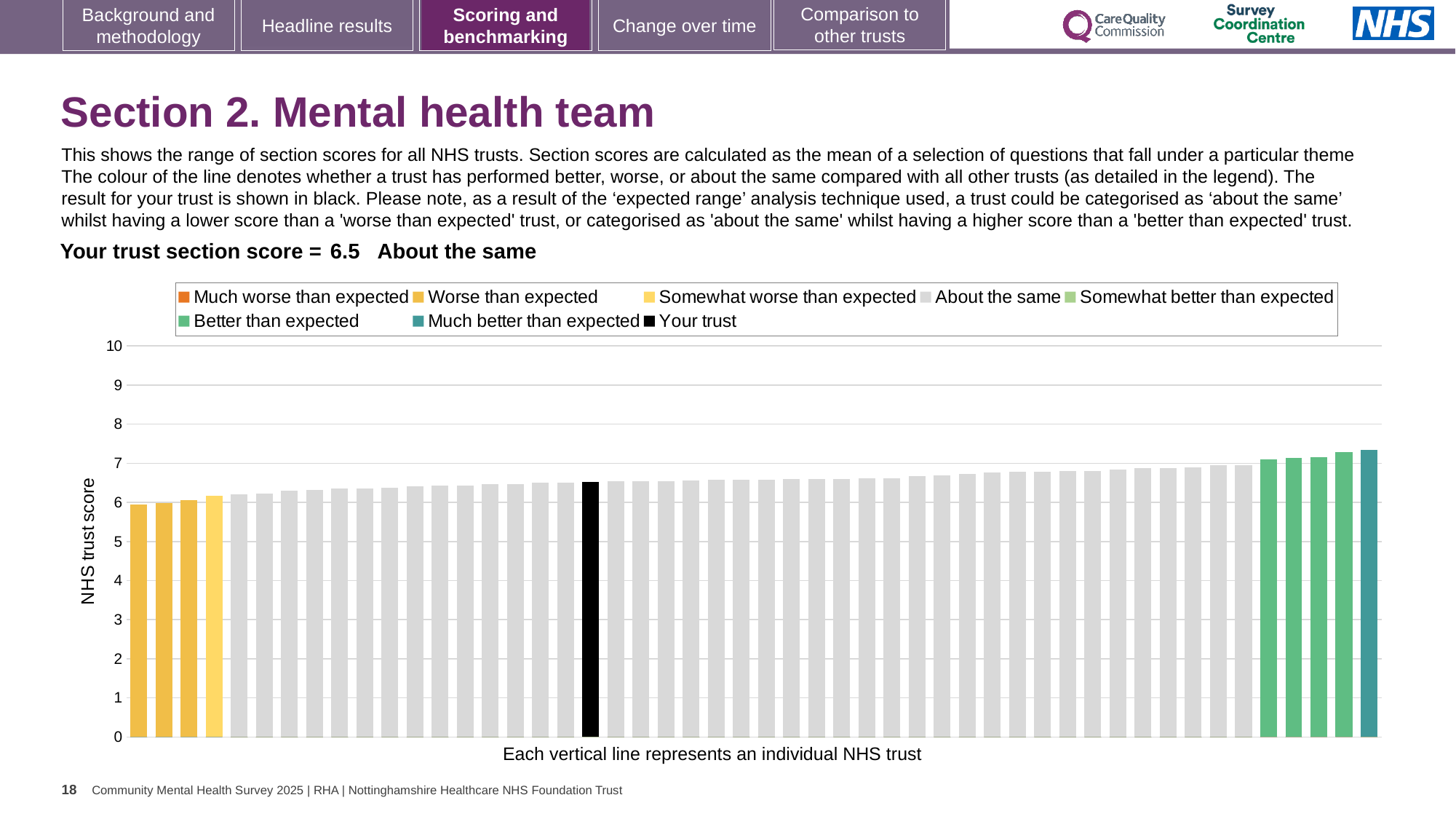
Is the value of the black 'Your trust' bar greater or less than 7? less What is the section score for your trust shown on the slide? 6.5 How many bars are coloured in the 'Better than expected' green colour? 4 What is the label on the vertical axis of the chart? NHS trust score Is the value of the tallest bar (rightmost) greater or less than 7? greater Do the bar values rise or fall from left to right along the x axis? rise According to the slide, which category does your trust's section score fall into? About the same Is the value of the shortest bar (leftmost) greater or less than 5? greater What kind of chart is shown on the slide? bar chart How many entries does the chart legend list? 8 How many bars are coloured in the 'Much better than expected' (teal) colour? 1